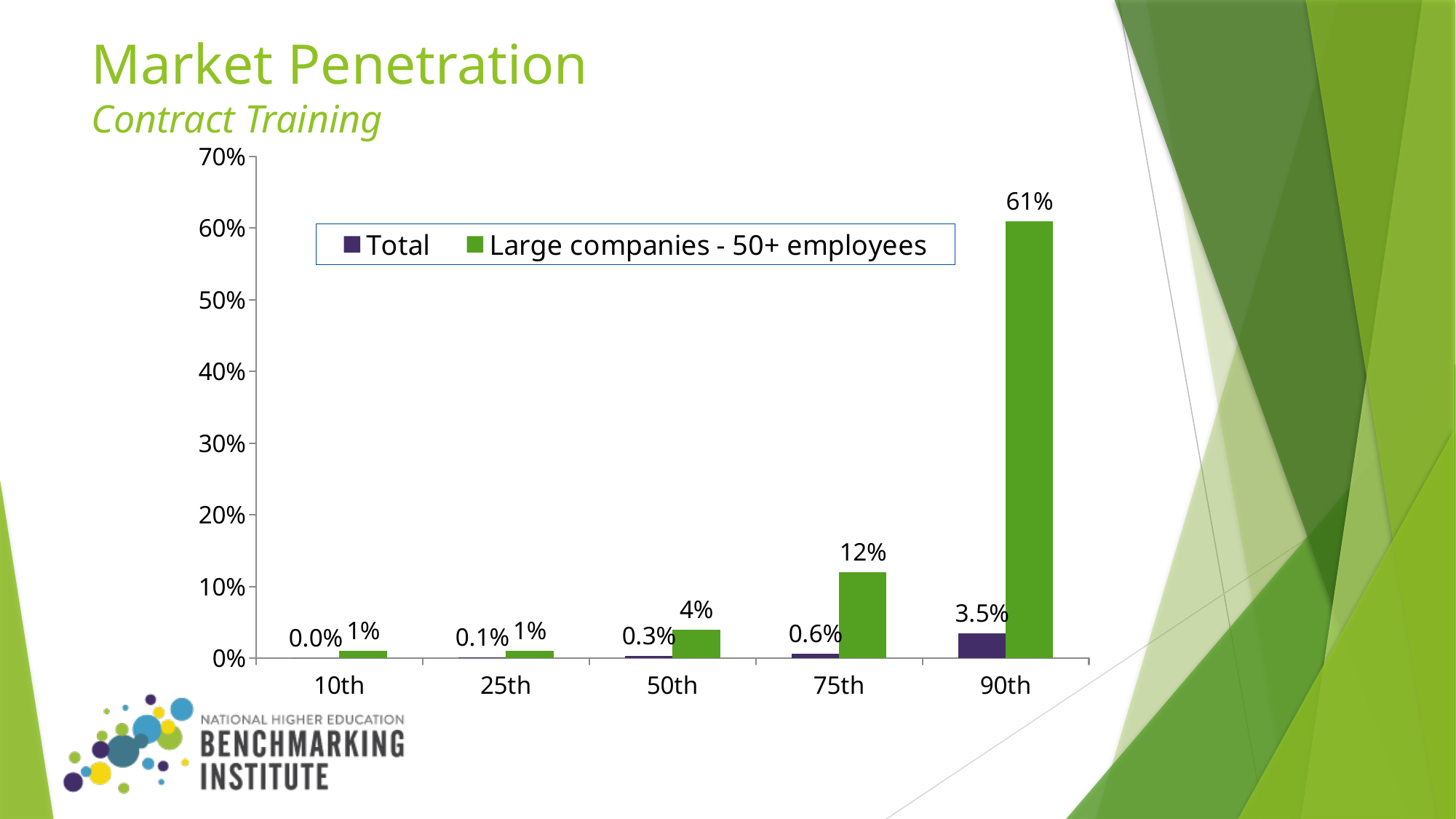
Is the value for Large companies - 50+ employees at the 90th percentile greater or less than 50%? greater Which is larger at the 90th percentile: Total or Large companies - 50+ employees? Large companies - 50+ employees What is the Total value at the 90th percentile? 3.5% What is the value for Large companies - 50+ employees at the 90th percentile? 61% What is the value for Large companies - 50+ employees at the 75th percentile? 12% What is the Total value at the 50th percentile? 0.3% Do the Large companies - 50+ employees values rise or fall from the 10th to the 90th percentile? rise What is the difference between the Large companies - 50+ employees value and the Total value at the 75th percentile? 11.4% At which percentile is the Total value lowest? 10th How many percentile categories are shown on the x axis? 5 How many series does the legend list? 2 At which percentile is the Large companies - 50+ employees value highest? 90th